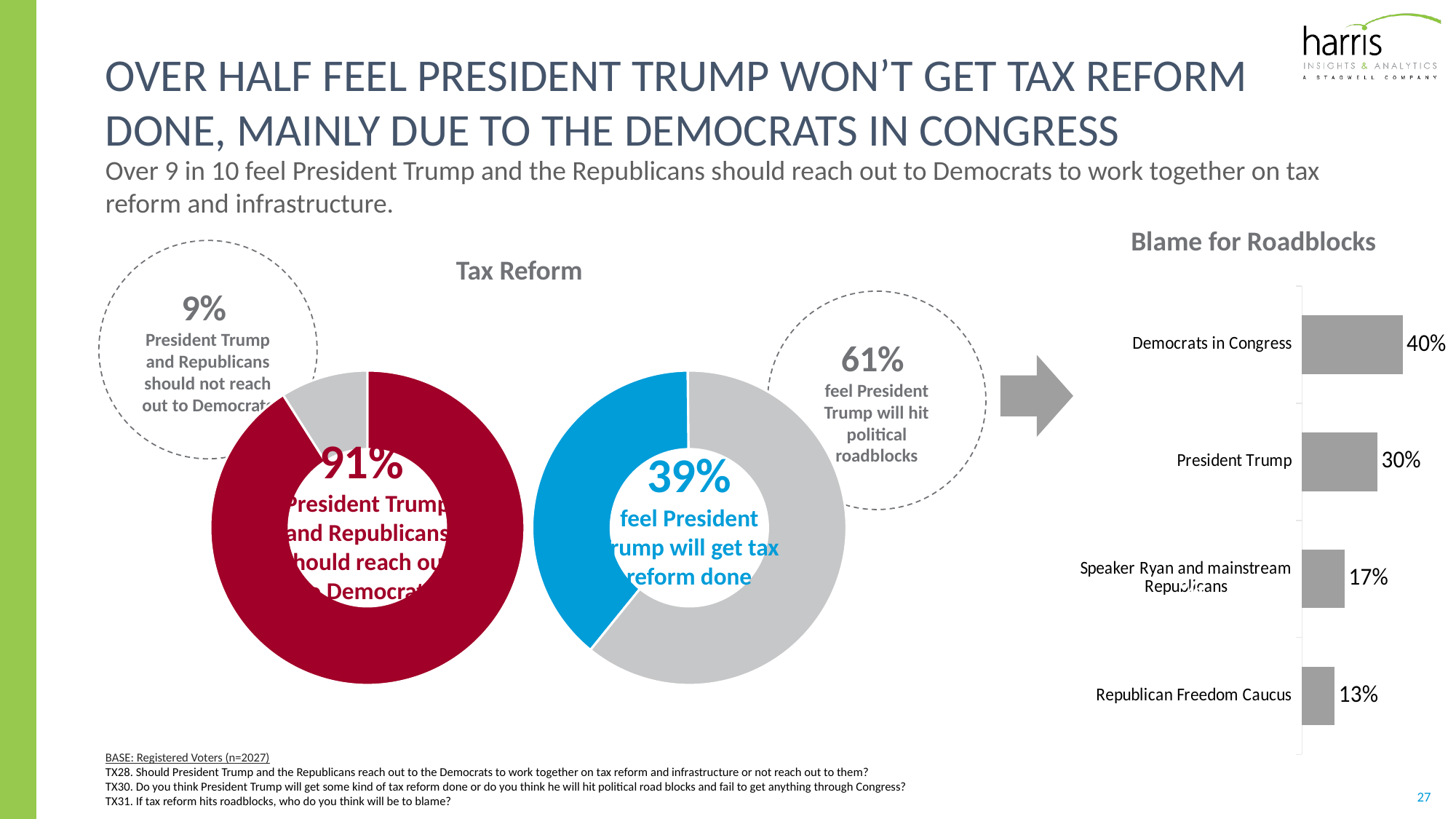
In the middle donut chart under Tax Reform, what percentage feel President Trump will hit political roadblocks? 61% In the Blame for Roadblocks bar chart, which is larger: Speaker Ryan and mainstream Republicans or Republican Freedom Caucus? Speaker Ryan and mainstream Republicans In the middle donut chart under Tax Reform, what is the difference between the share who feel Trump will hit political roadblocks and the share who feel he will get tax reform done? 22% In the Blame for Roadblocks bar chart, what is the difference between the values for Democrats in Congress and President Trump? 10% In the Blame for Roadblocks bar chart, what percentage blame President Trump? 30% How many categories are shown in the Blame for Roadblocks bar chart? 4 In the left donut chart under Tax Reform, what percentage feel President Trump and Republicans should reach out to Democrats? 91% In the Blame for Roadblocks bar chart, what percentage blame the Republican Freedom Caucus? 13% In the Blame for Roadblocks bar chart, which category has the highest value? Democrats in Congress What kind of chart is the Blame for Roadblocks chart? Bar chart In the Blame for Roadblocks bar chart, what percentage blame Democrats in Congress? 40% In the Blame for Roadblocks bar chart, which category has the lowest value? Republican Freedom Caucus